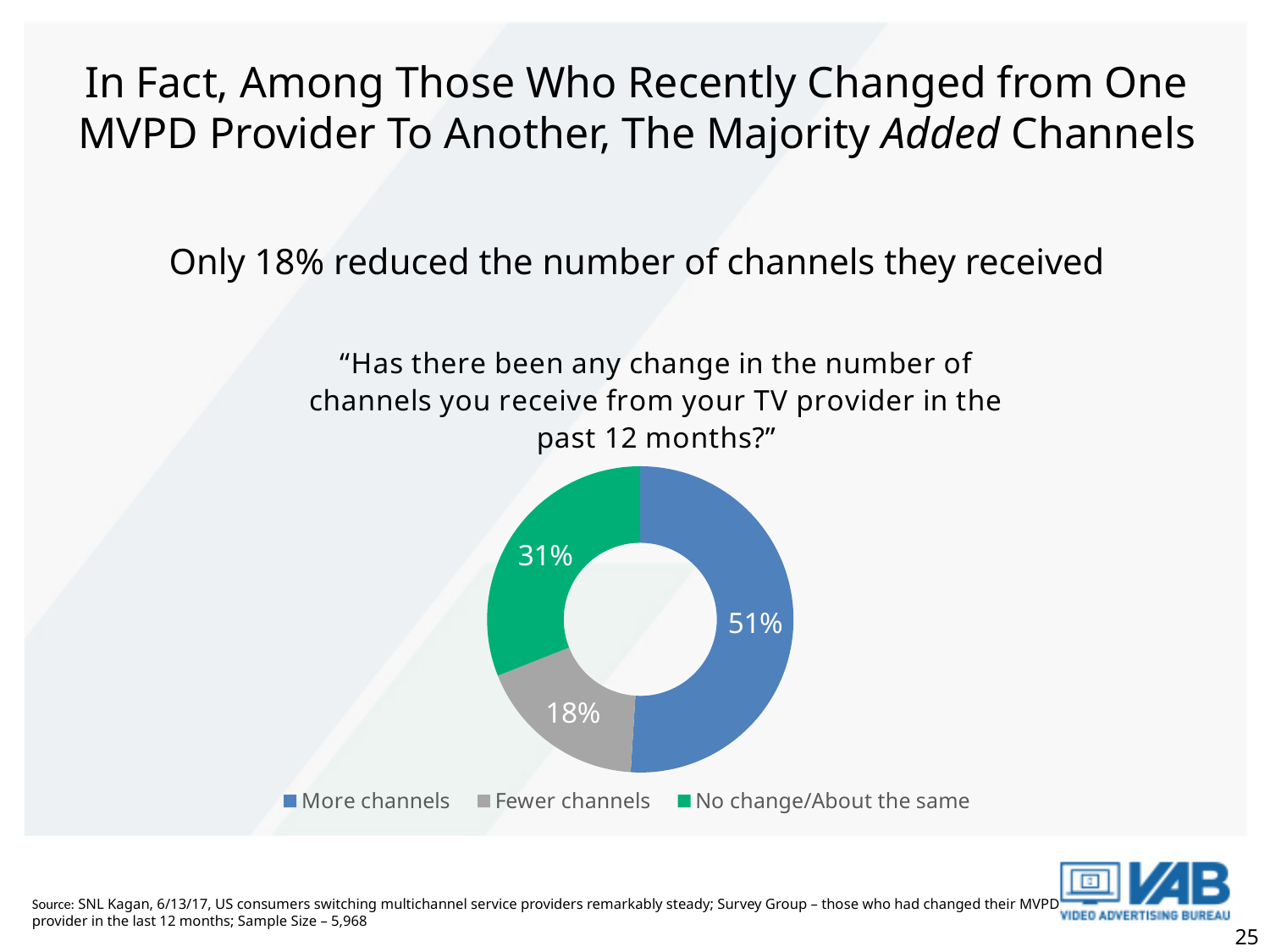
What percentage of respondents said there was no change/about the same number of channels? 31% How many categories does the chart show? 3 What percentage of respondents said they receive more channels? 51% What percentage of respondents said they receive fewer channels? 18% What kind of chart is shown on the slide? Pie chart (donut) Which is larger: the share for 'No change/About the same' or the share for 'Fewer channels'? No change/About the same What colour represents 'Fewer channels' in the chart? Gray What survey question is shown as the chart's title? "Has there been any change in the number of channels you receive from your TV provider in the past 12 months?" What is the difference in percentage points between 'More channels' and 'Fewer channels'? 33 What is the difference in percentage points between 'No change/About the same' and 'Fewer channels'? 13 Which response has the smallest share of the chart? Fewer channels Which response has the largest share of the chart? More channels